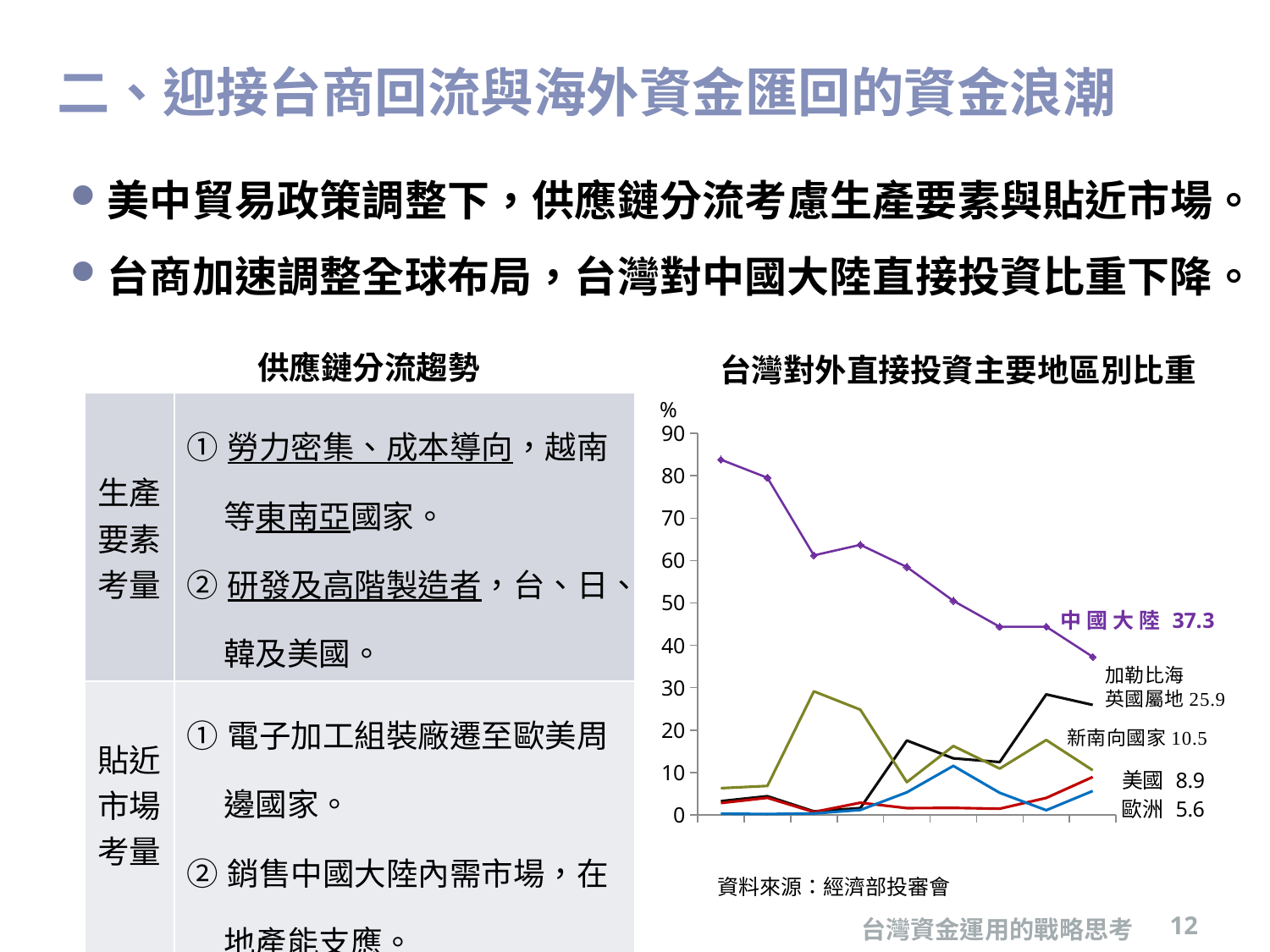
In the chart 台灣對外直接投資主要地區別比重, what is the final value labelled for 歐洲? 5.6 In the chart 台灣對外直接投資主要地區別比重, is the first value of the 中國大陸 line greater or less than 80? greater In the chart 台灣對外直接投資主要地區別比重, what is the final value labelled for 新南向國家? 10.5 In the chart 台灣對外直接投資主要地區別比重, what is the final value labelled for 加勒比海英國屬地? 25.9 In the chart 台灣對外直接投資主要地區別比重, which has a larger final value, 美國 or 新南向國家? 新南向國家 In the chart 台灣對外直接投資主要地區別比重, does the 中國大陸 line generally rise or fall along the x axis? fall In the chart 台灣對外直接投資主要地區別比重, what is the difference between the final values of 中國大陸 and 加勒比海英國屬地? 11.4 In the chart 台灣對外直接投資主要地區別比重, what is the final value labelled for 中國大陸? 37.3 What type of chart is 台灣對外直接投資主要地區別比重? line chart In the chart 台灣對外直接投資主要地區別比重, which region has the lowest final value? 歐洲 How many regions (lines) are labelled in the chart 台灣對外直接投資主要地區別比重? 5 In the chart 台灣對外直接投資主要地區別比重, which region has the highest final value? 中國大陸